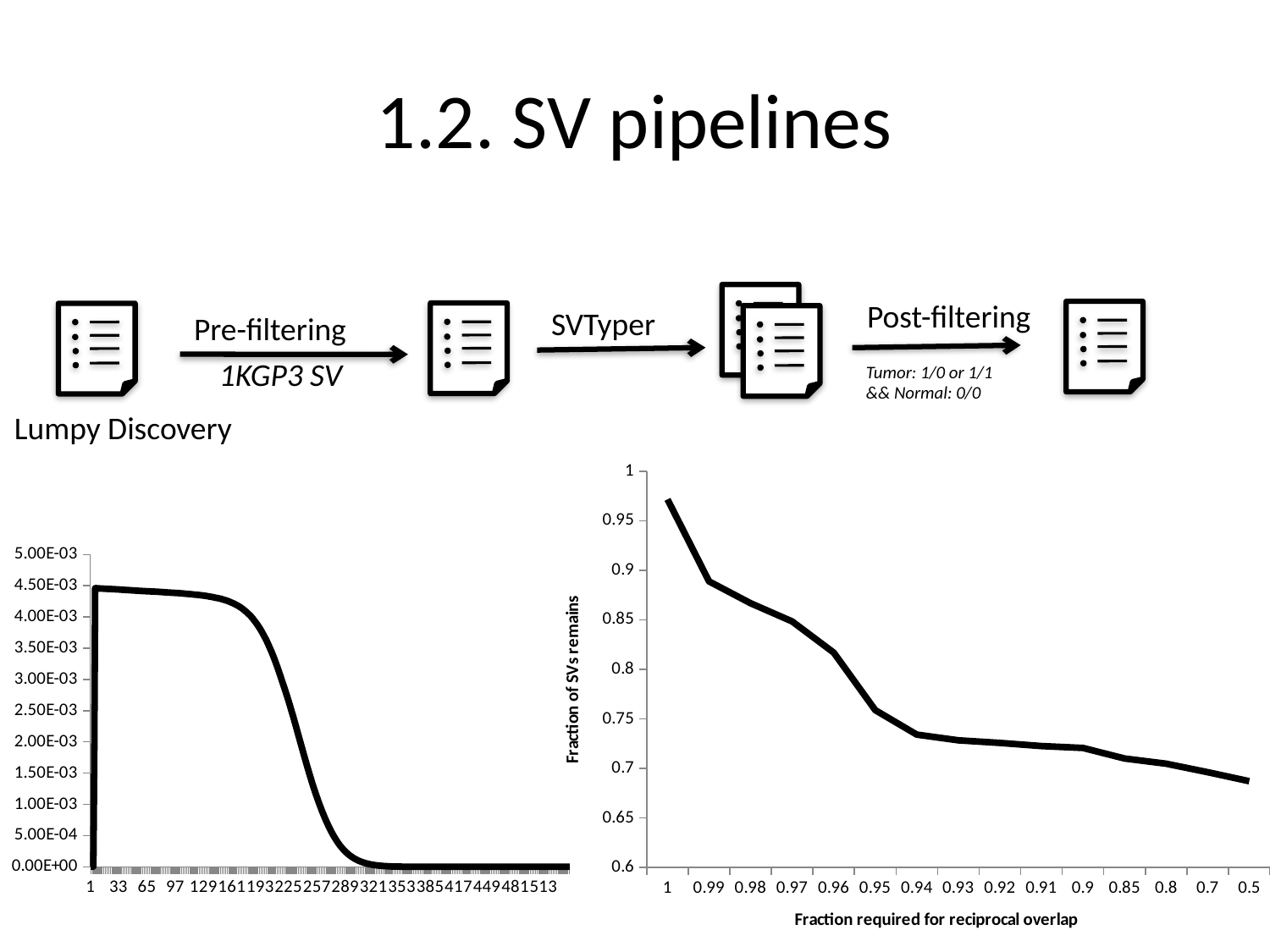
On the right-hand chart, at which x-axis category is the fraction of SVs remaining highest? 1 On the right-hand chart, at which x-axis category is the fraction of SVs remaining lowest? 0.5 What kind of chart is the right-hand chart, with the x-axis 'Fraction required for reciprocal overlap'? line chart On the right-hand chart, which is larger: the value at x = 0.99 or the value at x = 0.9? 0.99 On the right-hand chart, is the value at x = 1 greater or less than 0.95? greater On the right-hand chart, what is the x-axis title? Fraction required for reciprocal overlap On the right-hand chart, is the value at x = 0.5 greater or less than 0.7? less On the right-hand chart, do the values rise or fall as you move from left to right along the x axis? fall On the right-hand chart, how many x-axis categories are labelled? 15 On the right-hand chart, what is the y-axis title? Fraction of SVs remains On the left-hand chart, is the value at x = 385 greater or less than 5.00E-04? less What kind of chart is the left-hand chart, with the y-axis running from 0.00E+00 to 5.00E-03? line chart